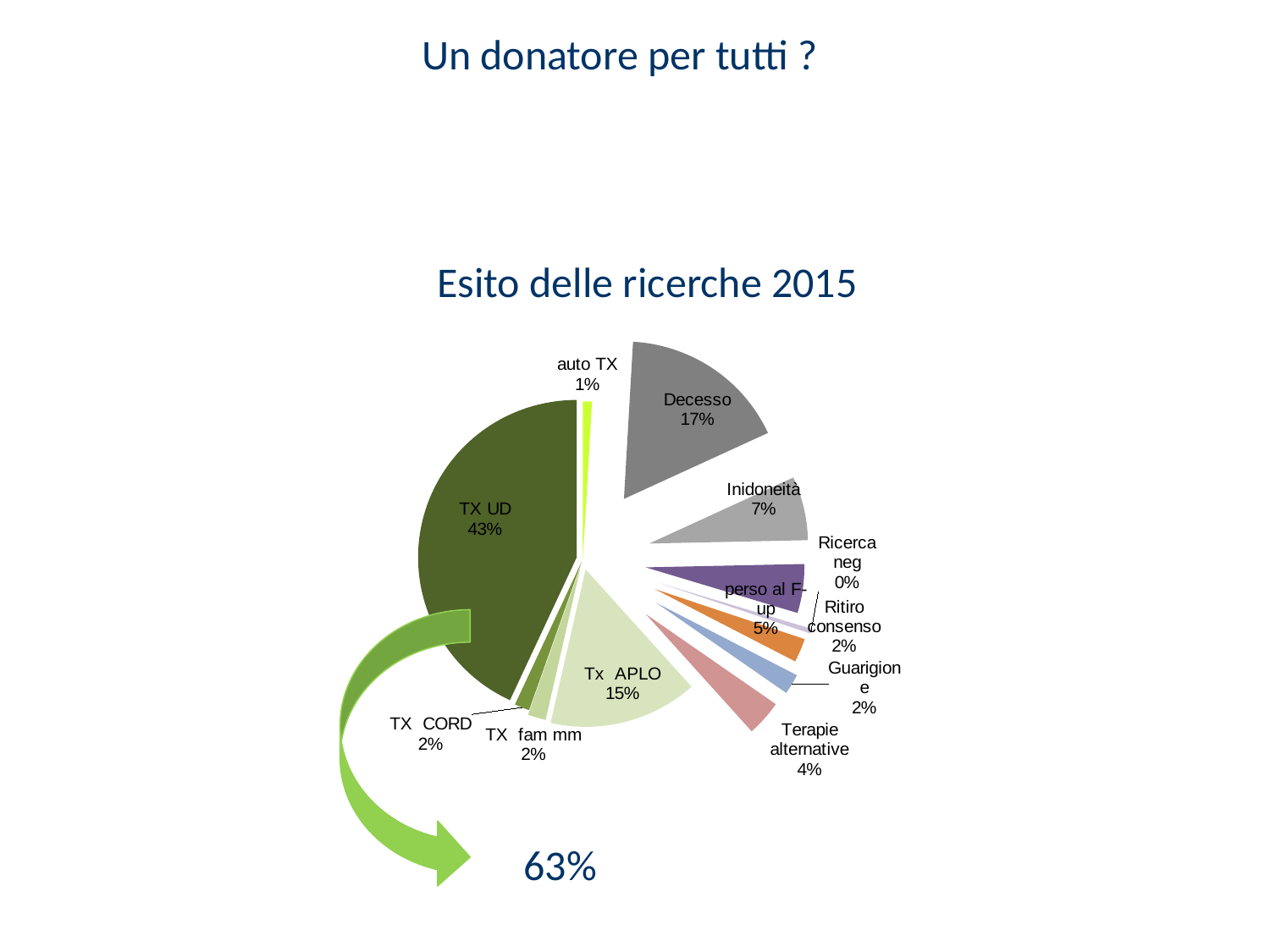
What percentage of the pie does the TX UD slice represent? 43% Which is larger, the share for perso al F-up or the share for Inidoneità? Inidoneità What is the difference between the Decesso and Tx APLO shares? 2% Which slice of the pie is the largest? TX UD What is the value shown for Decesso? 17% What is the title of the chart? Esito delle ricerche 2015 What share is shown for Tx APLO? 15% How many slices are labelled in the pie chart? 12 What is the value for Terapie alternative? 4% What type of chart is shown on the slide? pie chart Which slice has the smallest value shown? Ricerca neg What percentage is shown for Inidoneità? 7%